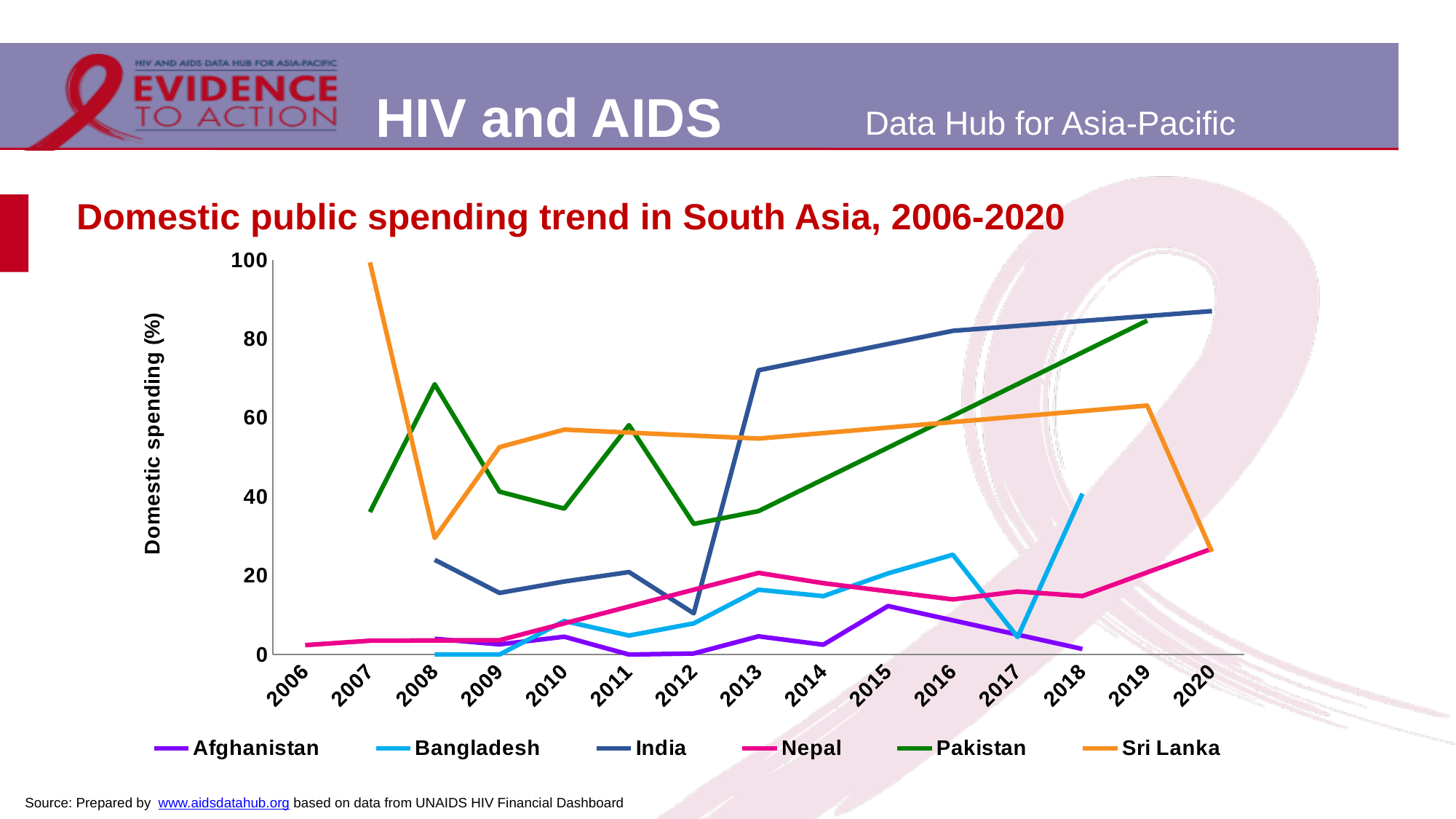
Is the value for Sri Lanka in 2007 greater or less than 80? greater Is the value for Afghanistan in 2015 greater or less than 20? less How many years are shown on the x axis? 15 What is the label of the y axis? Domestic spending (%) How many series does the legend list? 6 Is the value for India in 2013 greater or less than 60? greater What kind of chart is shown on the slide? line chart Which series has the highest value in 2020? India Does the value for India rise or fall from 2013 to 2020? rise In 2016, which is larger: the value for India or the value for Pakistan? India What is the title of the chart? Domestic public spending trend in South Asia, 2006-2020